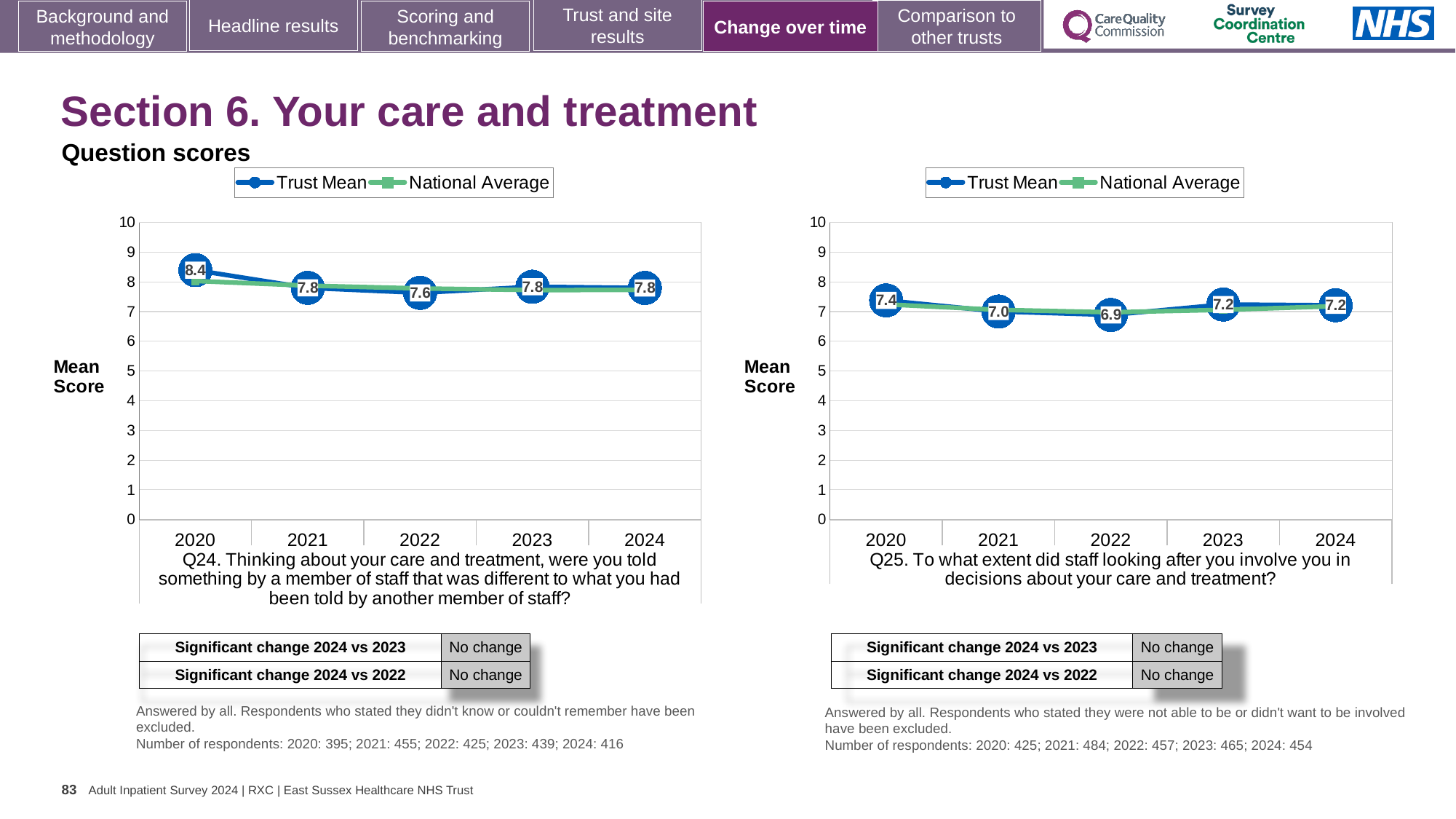
In the Q24 chart, what is the Trust Mean score for 2022? 7.6 How many series does the legend of the Q25 chart list? 2 In the Q25 chart, what is the Trust Mean score for 2021? 7.0 In the Q25 chart, which year has the lowest Trust Mean score? 2022 What kind of chart is the Q24 chart? Line chart How many years are shown on the x axis of the Q24 chart? 5 In the Q24 chart, what is the difference between the Trust Mean scores for 2020 and 2022? 0.8 In the Q24 chart, which year has the highest Trust Mean score? 2020 In the Q25 chart, is the Trust Mean score for 2020 or 2022 larger? 2020 In the Q25 chart, what is the Trust Mean score for 2024? 7.2 In the Q24 chart, what is the Trust Mean score for 2020? 8.4 In the Q25 chart, is the Trust Mean score for 2022 greater or less than 8? less